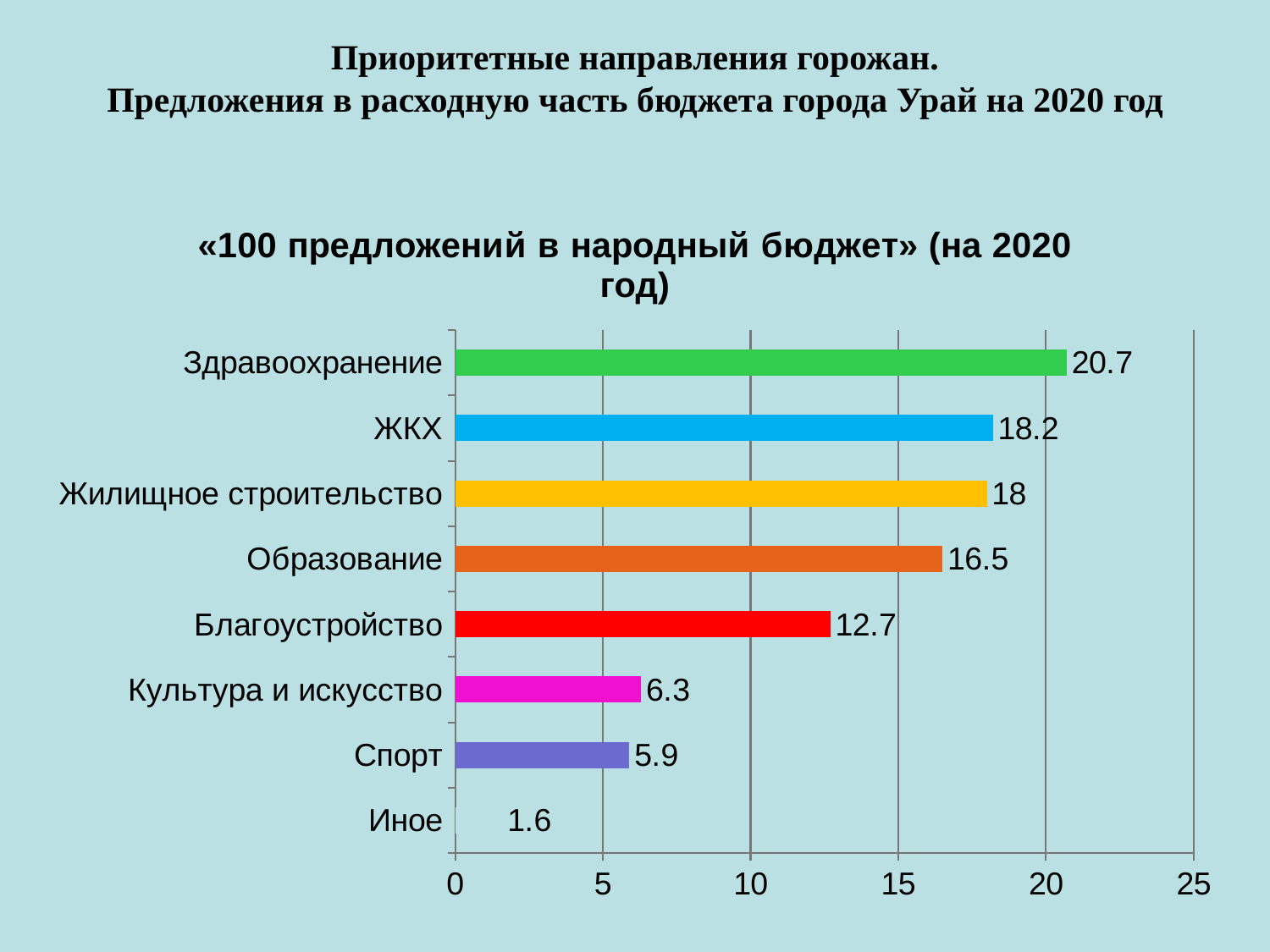
What is the value for Образование? 16.5 Which category has the highest value? Здравоохранение How many categories are shown in the chart? 8 Is the value for Образование greater or less than 15? greater Which is larger, the value for Благоустройство or the value for Культура и искусство? Благоустройство What is the value for Здравоохранение? 20.7 What is the title of the chart? «100 предложений в народный бюджет» (на 2020 год) What is the difference between the values for Здравоохранение and Спорт? 14.8 Which category has the lowest value? Иное What kind of chart is shown on the slide? bar chart What is the value for Иное? 1.6 What is the difference between the values for ЖКХ and Жилищное строительство? 0.2